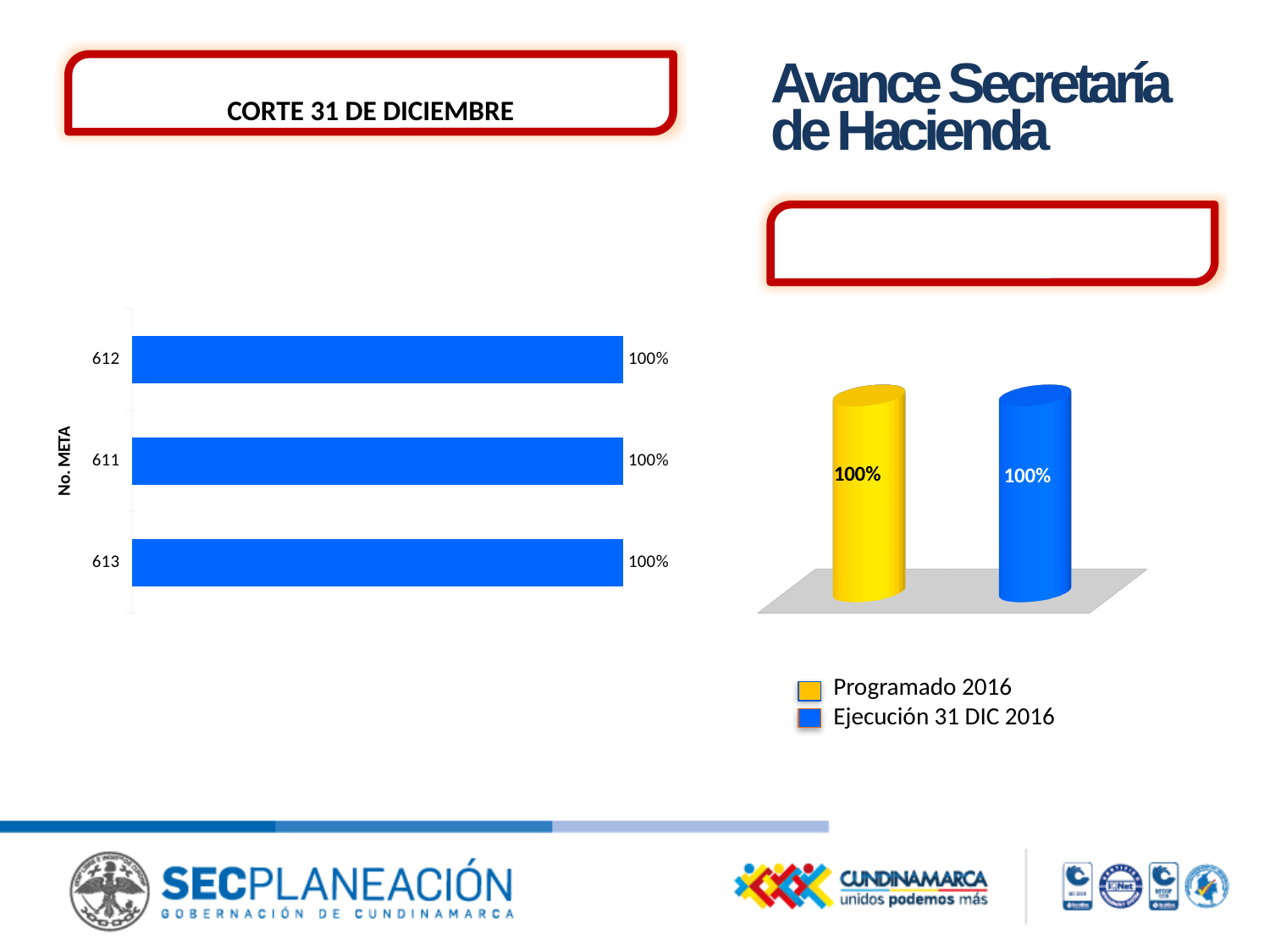
On the left chart, what is the label of the vertical axis? No. META On the right chart, what is the value for Ejecución 31 DIC 2016? 100% On the left chart, what is the value for meta 612? 100% On the left chart, what is the value for meta 611? 100% On the right chart, what is the difference between Programado 2016 and Ejecución 31 DIC 2016? 0% On the left chart, what is the value for meta 613? 100% What kind of chart is the left chart? Bar chart On the right chart, which colour represents Programado 2016? Yellow On the left chart, what is the difference between the values for meta 612 and meta 613? 0% On the right chart, what is the value for Programado 2016? 100% On the right chart, how many series does the legend list? 2 On the left chart, how many metas (categories) are plotted? 3